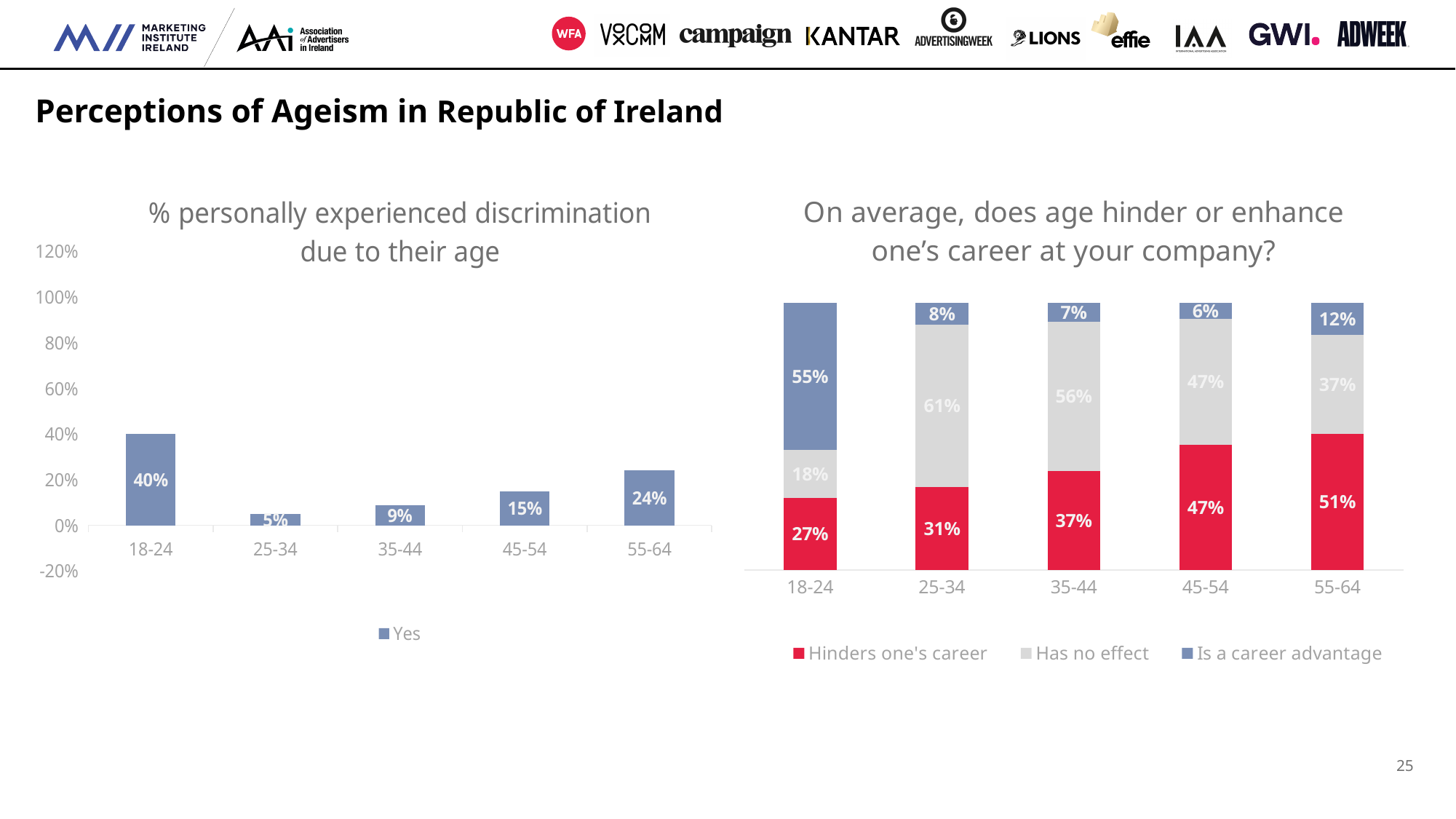
What kind of chart is the one on the right of the slide? stacked bar chart In the chart 'On average, does age hinder or enhance one's career at your company?', which age group has the highest 'Has no effect' value? 25-34 In the chart '% personally experienced discrimination due to their age', which age group has the highest value? 18-24 In the chart 'On average, does age hinder or enhance one's career at your company?', how many series does the legend list? 3 In the chart 'On average, does age hinder or enhance one's career at your company?', what is the 'Hinders one's career' value for the 45-54 age group? 47% In the chart '% personally experienced discrimination due to their age', what is the difference between the values for 55-64 and 45-54? 9% In the chart 'On average, does age hinder or enhance one's career at your company?', what is the 'Is a career advantage' value for the 18-24 age group? 55% In the chart '% personally experienced discrimination due to their age', how many age groups are shown? 5 In the chart '% personally experienced discrimination due to their age', which age group has the lowest value? 25-34 In the chart 'On average, does age hinder or enhance one's career at your company?', what is the total of the stacked bar for the 55-64 age group? 100% In the chart '% personally experienced discrimination due to their age', what is the value for the 18-24 age group? 40% In the chart 'On average, does age hinder or enhance one's career at your company?', does the 'Hinders one's career' value rise or fall as age group increases from 18-24 to 55-64? rise